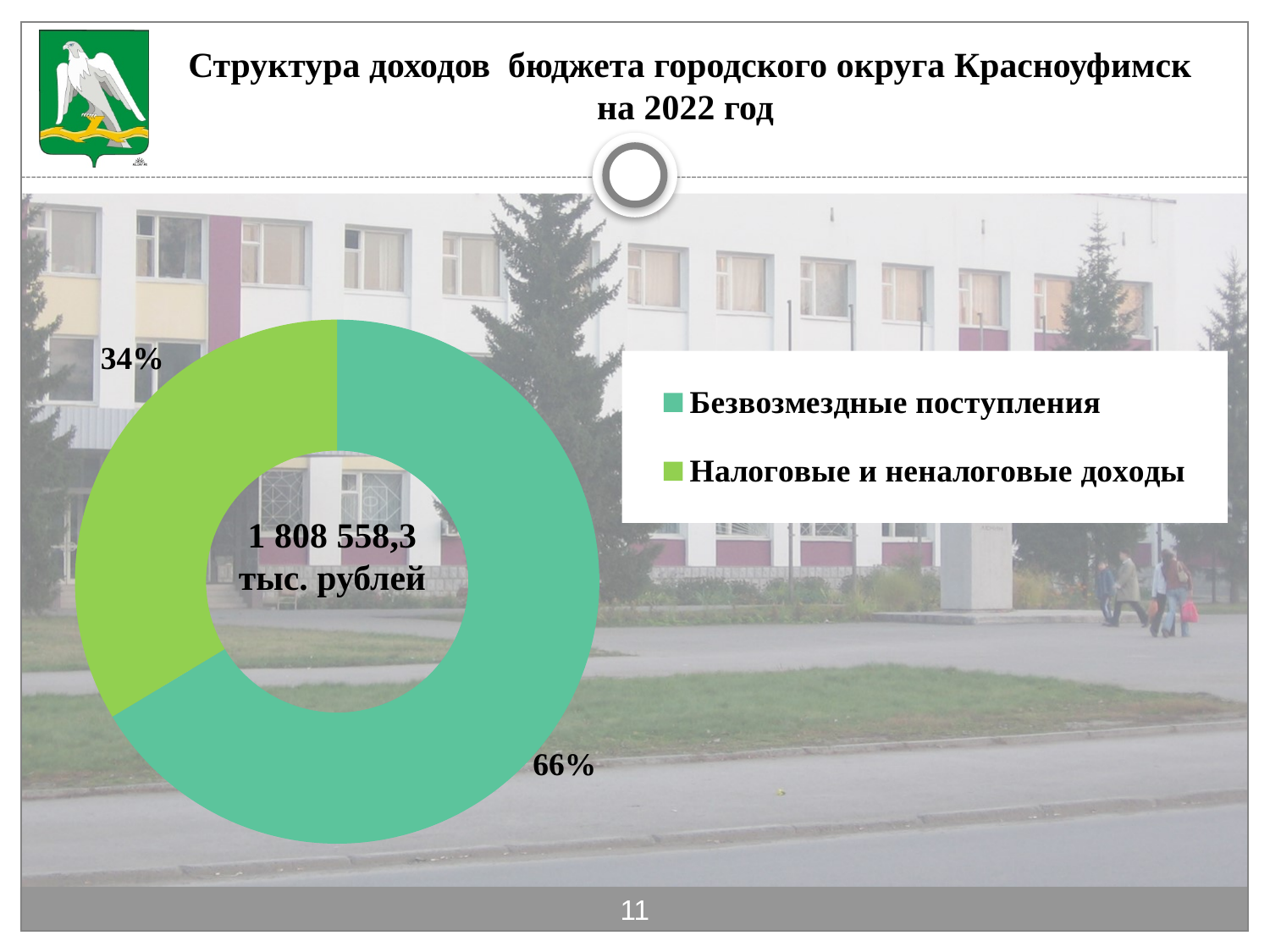
What share of the budget revenue is Безвозмездные поступления? 66% Which category has the largest share of the budget revenue? Безвозмездные поступления What total value is printed in the centre of the chart? 1 808 558,3 тыс. рублей What is the difference in percentage points between the shares of Безвозмездные поступления and Налоговые и неналоговые доходы? 32 What share of the budget revenue is Налоговые и неналоговые доходы? 34% How many categories does the chart show? 2 What kind of chart is shown on the slide? Pie chart (doughnut) How many entries does the legend list? 2 Which is larger: the share of Безвозмездные поступления or the share of Налоговые и неналоговые доходы? Безвозмездные поступления What is the title of the slide? Структура доходов бюджета городского округа Красноуфимск на 2022 год Which legend entry is shown in light green? Налоговые и неналоговые доходы Which category has the smallest share of the budget revenue? Налоговые и неналоговые доходы